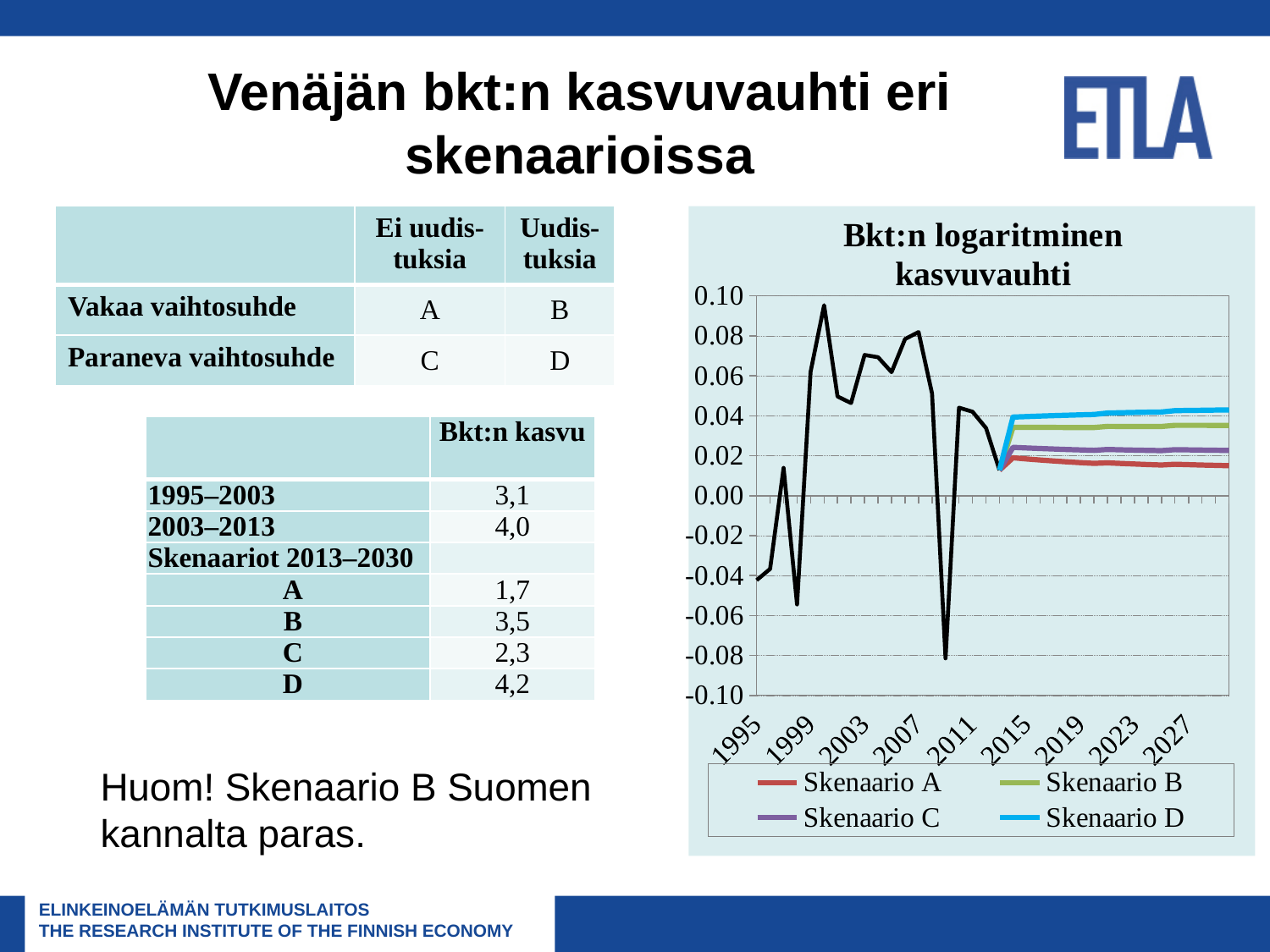
How many year labels are shown on the x axis of the chart? 9 How many series does the legend of the chart list? 4 Is the value for Skenaario B around 2027 greater or less than 0.04? less What is the title of the chart? Bkt:n logaritminen kasvuvauhti Is the highest point of the black line (around 2000) greater or less than 0.08? greater What colour is the Skenaario D line in the chart? light blue What kind of chart is shown on the slide? line chart Around 2027, which is larger: the value for Skenaario B or the value for Skenaario C? Skenaario B Is the lowest point of the black line (around 2009) greater or less than -0.06? less Does the Skenaario A line rise or fall from 2015 to 2027? fall Which scenario line is the lowest at the right end of the chart (around 2027)? Skenaario A Which scenario line is the highest at the right end of the chart (around 2027)? Skenaario D